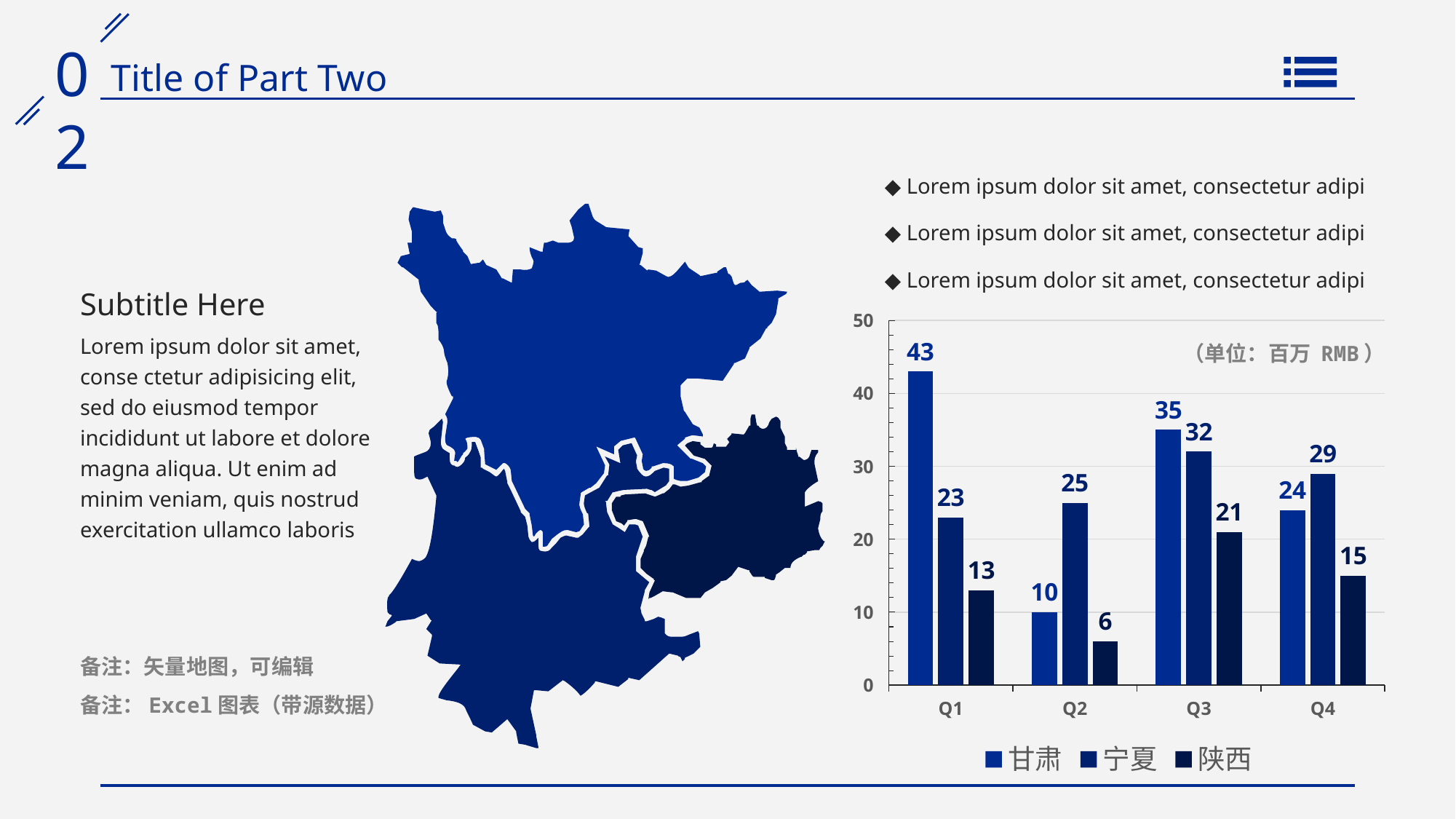
In which quarter is the value for 甘肃 the lowest? Q2 Does the value for 陕西 rise or fall from Q3 to Q4? fall How many quarters are shown on the x axis? 4 What kind of chart is shown on the slide? bar chart What unit is stated in the chart's annotation? 百万 RMB What is the value for 甘肃 in Q1? 43 What is the value for 陕西 in Q2? 6 Which is larger in Q4: 甘肃 or 宁夏? 宁夏 What is the value for 宁夏 in Q4? 29 In which quarter is the value for 宁夏 the highest? Q3 What is the difference between 甘肃 and 陕西 in Q1? 30 How many series does the legend list? 3